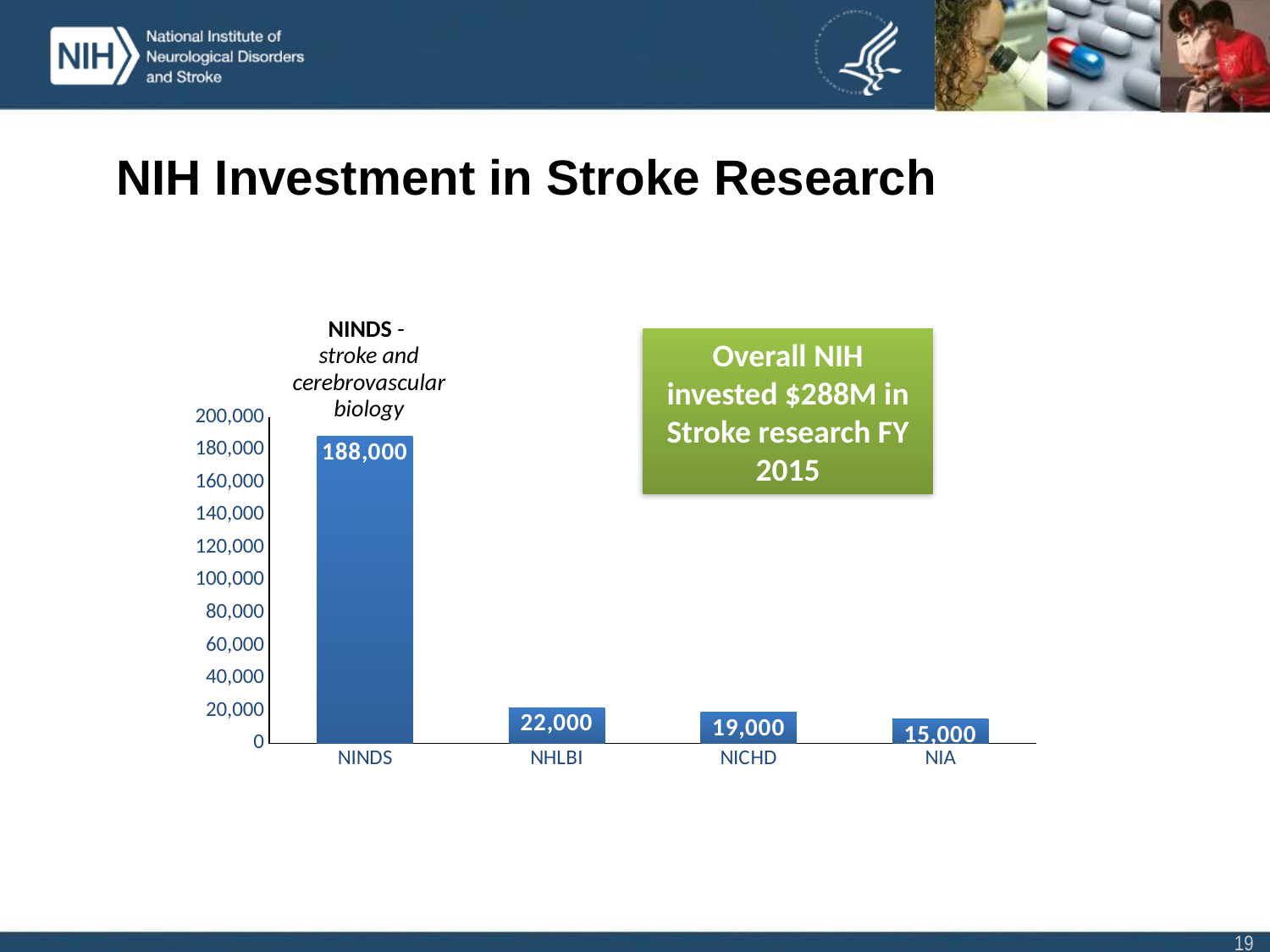
What is the value for NHLBI? 22,000 What is the difference between the values for NINDS and NHLBI? 166,000 What is the difference between the values for NICHD and NIA? 4,000 According to the green box on the slide, how much did NIH overall invest in stroke research in FY 2015? $288M What kind of chart is shown on the slide? Bar chart How many categories are shown on the x axis? 4 Which category has the highest value? NINDS Which category has the lowest value? NIA What is the value for NINDS? 188,000 What is the value for NICHD? 19,000 Which is larger, the value for NHLBI or the value for NIA? NHLBI What is the value for NIA? 15,000